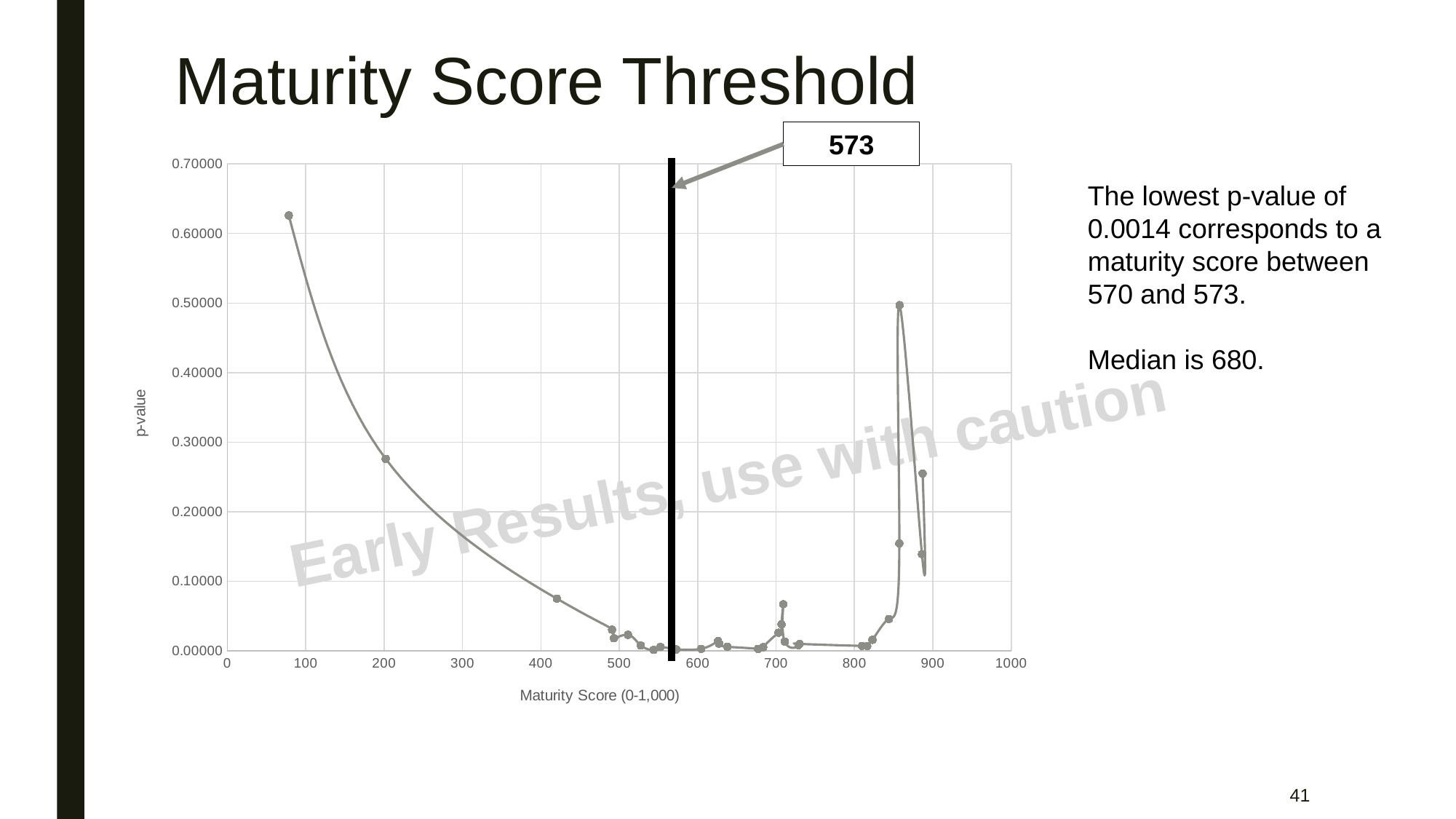
What kind of chart is shown on the slide? line chart Is the p-value for the point at a maturity score of about 200 greater or less than 0.30000? less What maturity score does the vertical black line on the chart mark? 573 Is the p-value at the peak near a maturity score of 850 greater or less than 0.40000? greater Does the highest p-value on the chart occur at a maturity score below 100 or above 800? below 100 Is the p-value for the leftmost point (maturity score below 100) greater or less than 0.60000? greater What is the title of the x axis of the chart? Maturity Score (0-1,000) Do the p-values rise or fall as the maturity score increases from 0 to 500? fall What is the highest value shown on the p-value axis? 0.70000 Which has the larger p-value: the point at a maturity score of about 200 or the peak near 850? the peak near 850